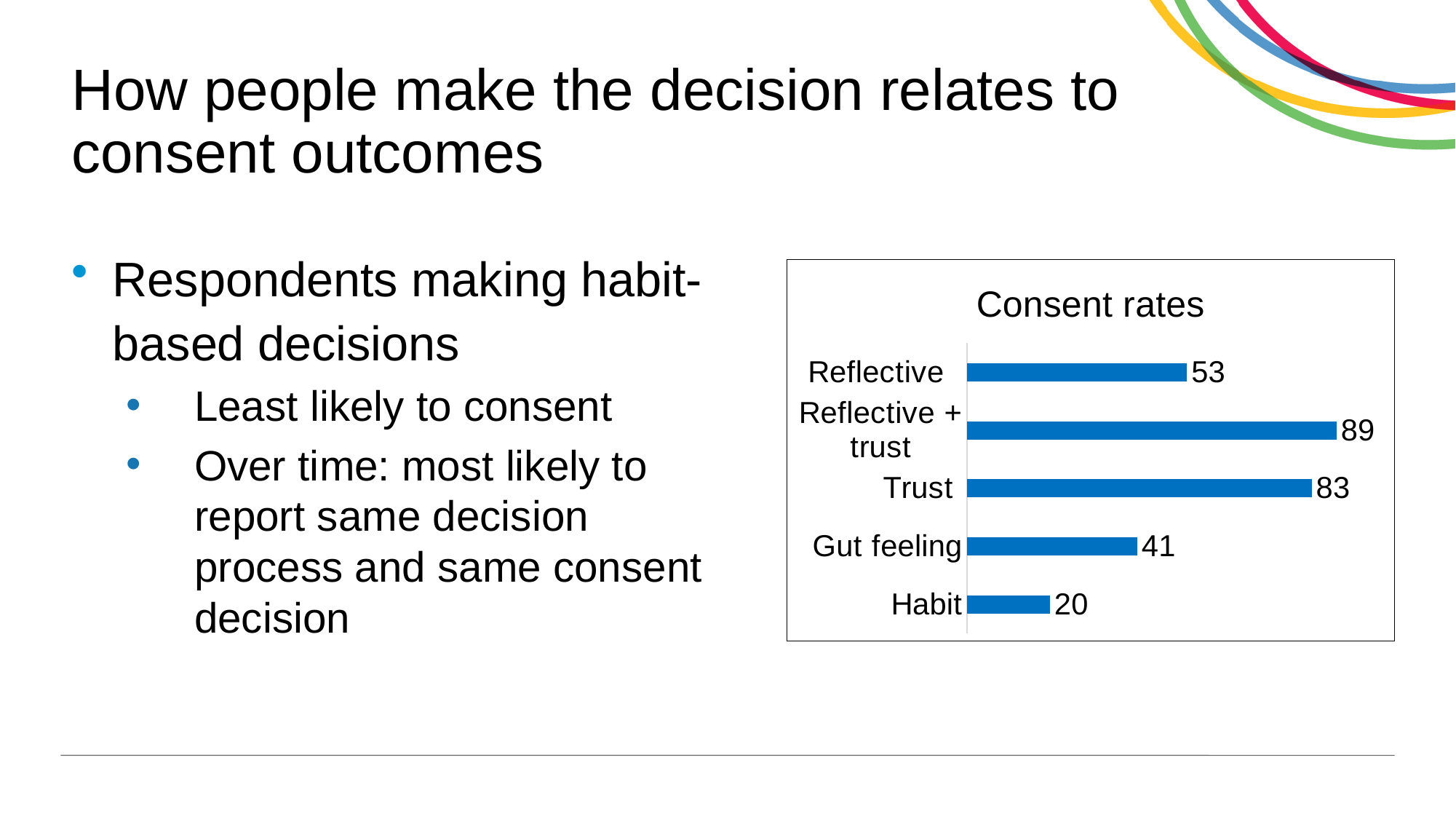
What kind of chart is shown on the slide? Bar chart What is the consent rate for Gut feeling? 41 What is the difference between the consent rates for Reflective and Gut feeling? 12 Which has a higher consent rate, Trust or Reflective? Trust What is the title of the chart? Consent rates What is the consent rate for Reflective + trust? 89 What is the consent rate for Trust? 83 Which category has the highest consent rate? Reflective + trust What is the consent rate for Habit? 20 Which category has the lowest consent rate? Habit How many categories are shown in the chart? 5 What is the difference between the consent rates for Reflective + trust and Habit? 69